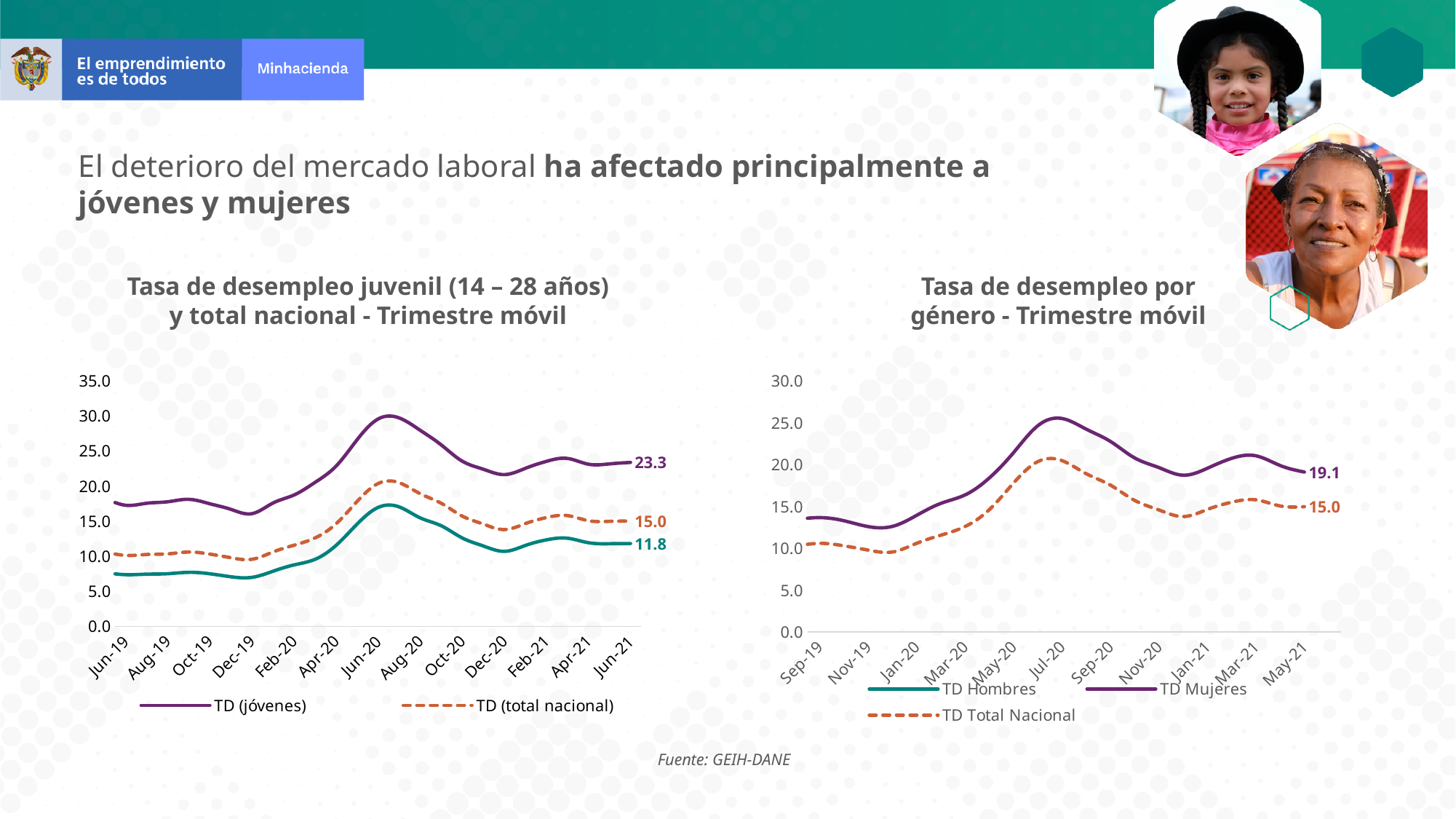
What kind of chart is the left chart (Tasa de desempleo juvenil y total nacional)? Line chart In the left chart (Tasa de desempleo juvenil y total nacional), what is the last labelled value of the TD (jóvenes) series? 23.3 In the left chart (Tasa de desempleo juvenil y total nacional), does the TD (jóvenes) series rise or fall between Jun-20 and Dec-20? Fall In the left chart (Tasa de desempleo juvenil y total nacional), what is the difference between the final labelled values of TD (jóvenes) and TD (total nacional)? 8.3 In the left chart (Tasa de desempleo juvenil y total nacional), is the peak value of TD (jóvenes) around Jun-20 greater or less than 25.0? greater How many series does the legend of the left chart (Tasa de desempleo juvenil y total nacional) list? 2 In the right chart (Tasa de desempleo por género), what is the last labelled value of the TD Mujeres series? 19.1 In the right chart (Tasa de desempleo por género), what is the last labelled value of the TD Total Nacional series? 15.0 In the left chart (Tasa de desempleo juvenil y total nacional), what is the last labelled value of the TD (total nacional) series? 15.0 How many series does the legend of the right chart (Tasa de desempleo por género) list? 3 In the right chart (Tasa de desempleo por género), what is the difference between the final labelled values of TD Mujeres and TD Total Nacional? 4.1 In the left chart (Tasa de desempleo juvenil y total nacional), which series is higher at Jun-21, TD (jóvenes) or TD (total nacional)? TD (jóvenes)